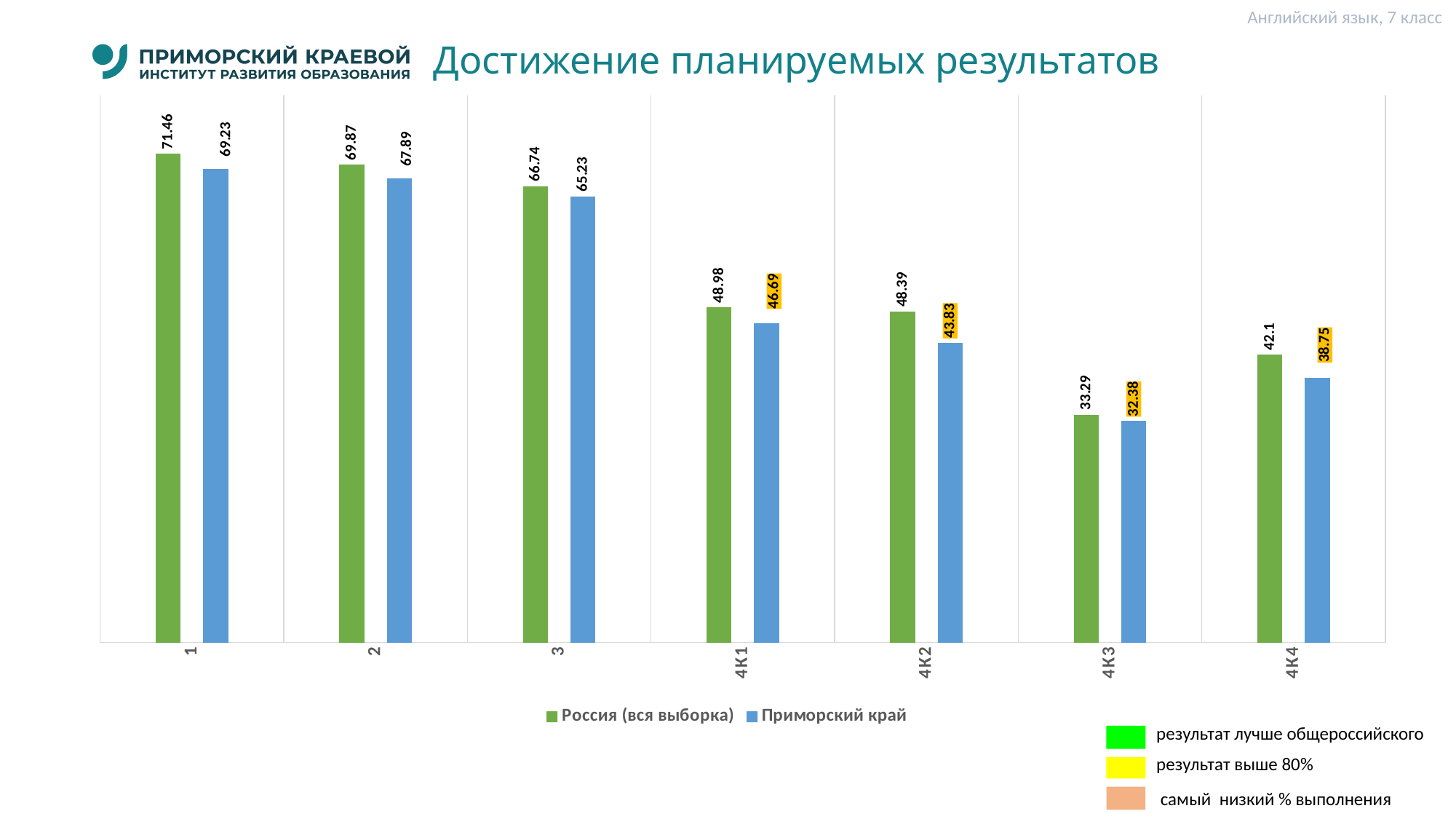
Which is larger in category 2: Россия (вся выборка) or Приморский край? Россия (вся выборка) What is the difference between Россия (вся выборка) and Приморский край in category 4К1? 2.29 How many categories are shown on the x axis? 7 What is the value for Приморский край in category 1? 69.23 Do the values for Приморский край rise or fall from category 1 to category 3? Fall What kind of chart is shown on the slide? Bar chart How many series does the legend list? 2 What is the value for Приморский край in category 4К4? 38.75 Which category has the highest value for Россия (вся выборка)? 1 What colour represents Приморский край in the chart? Blue What is the value for Россия (вся выборка) in category 4К3? 33.29 Which category has the lowest value for Приморский край? 4К3